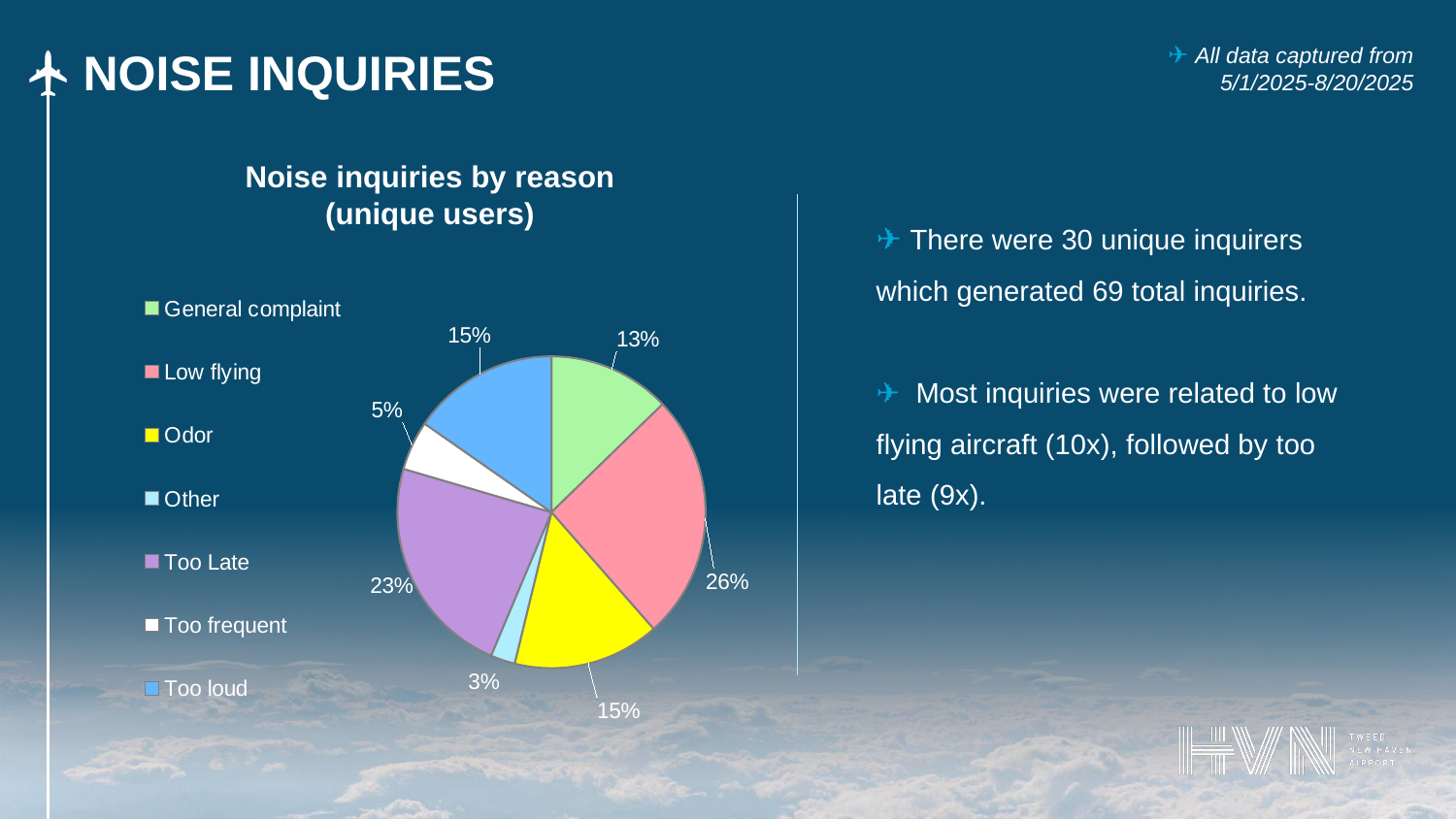
What colour is the Too Late slice? purple Which reason has the smallest share of the pie? Other What share of noise inquiries is for Too Late? 23% What share of noise inquiries is for Too frequent? 5% What share of noise inquiries is for Low flying? 26% What is the title of the chart? Noise inquiries by reason (unique users) What kind of chart is shown on the slide? pie chart What is the difference in percentage points between Low flying and Too Late? 3 How many categories does the legend list? 7 Which has a larger share, Odor or General complaint? Odor Which reason has the largest share of the pie? Low flying